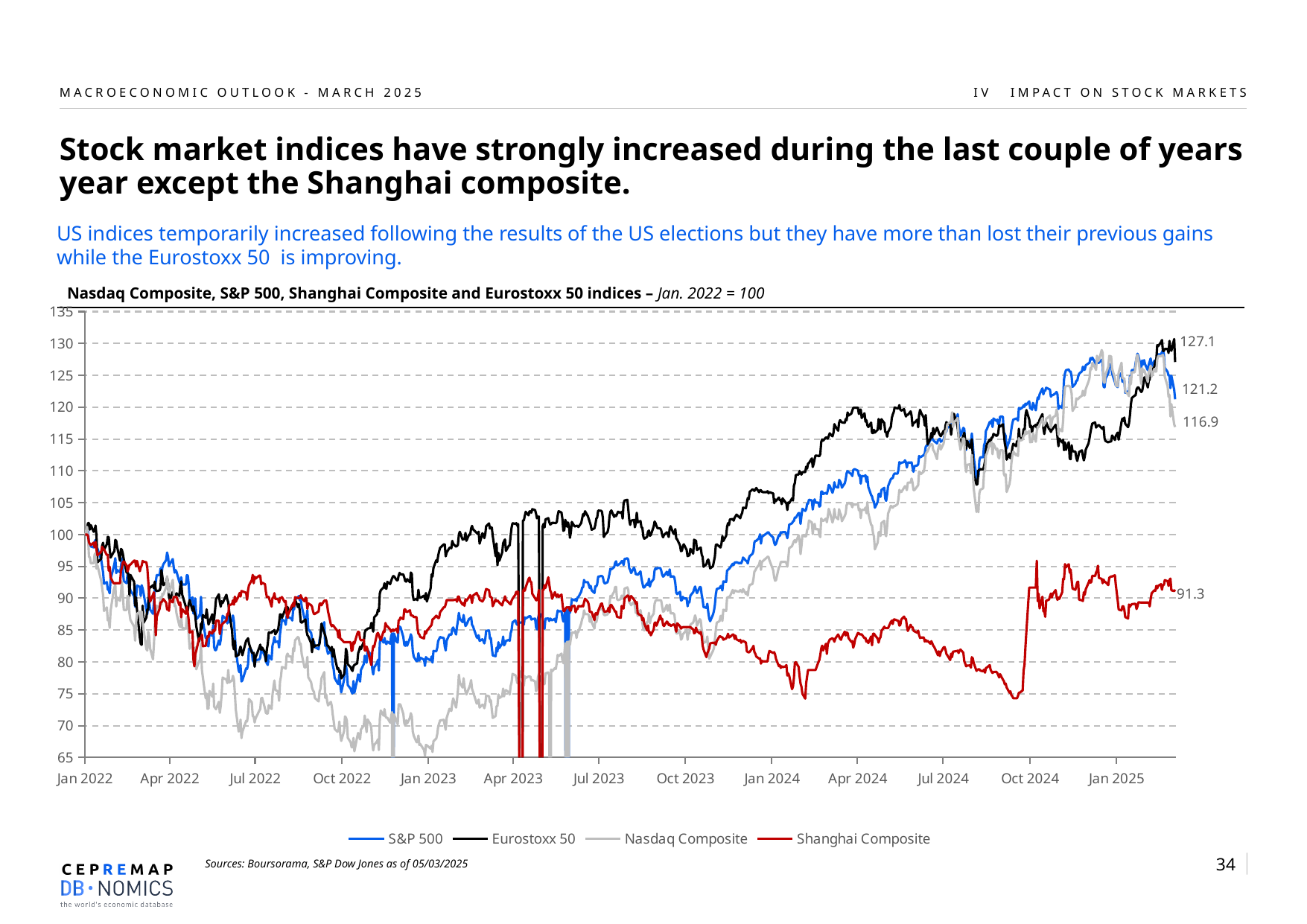
Which index has the lowest value at the end of the series? Shanghai Composite What is the difference between the latest values of the Eurostoxx 50 and the Shanghai Composite? 35.8 How many series does the legend list? 4 What is the latest value shown for the Shanghai Composite index? 91.3 What is the latest value shown for the S&P 500 index? 121.2 What type of chart is shown on the slide? line chart Which index has the highest value at the end of the series? Eurostoxx 50 What base period is the index set to 100 in the chart title? Jan. 2022 What is the latest value shown for the Eurostoxx 50 index? 127.1 Is the latest value of the S&P 500 or the Nasdaq Composite larger? S&P 500 Is the latest value of the Shanghai Composite greater or less than 100? less What is the latest value shown for the Nasdaq Composite index? 116.9